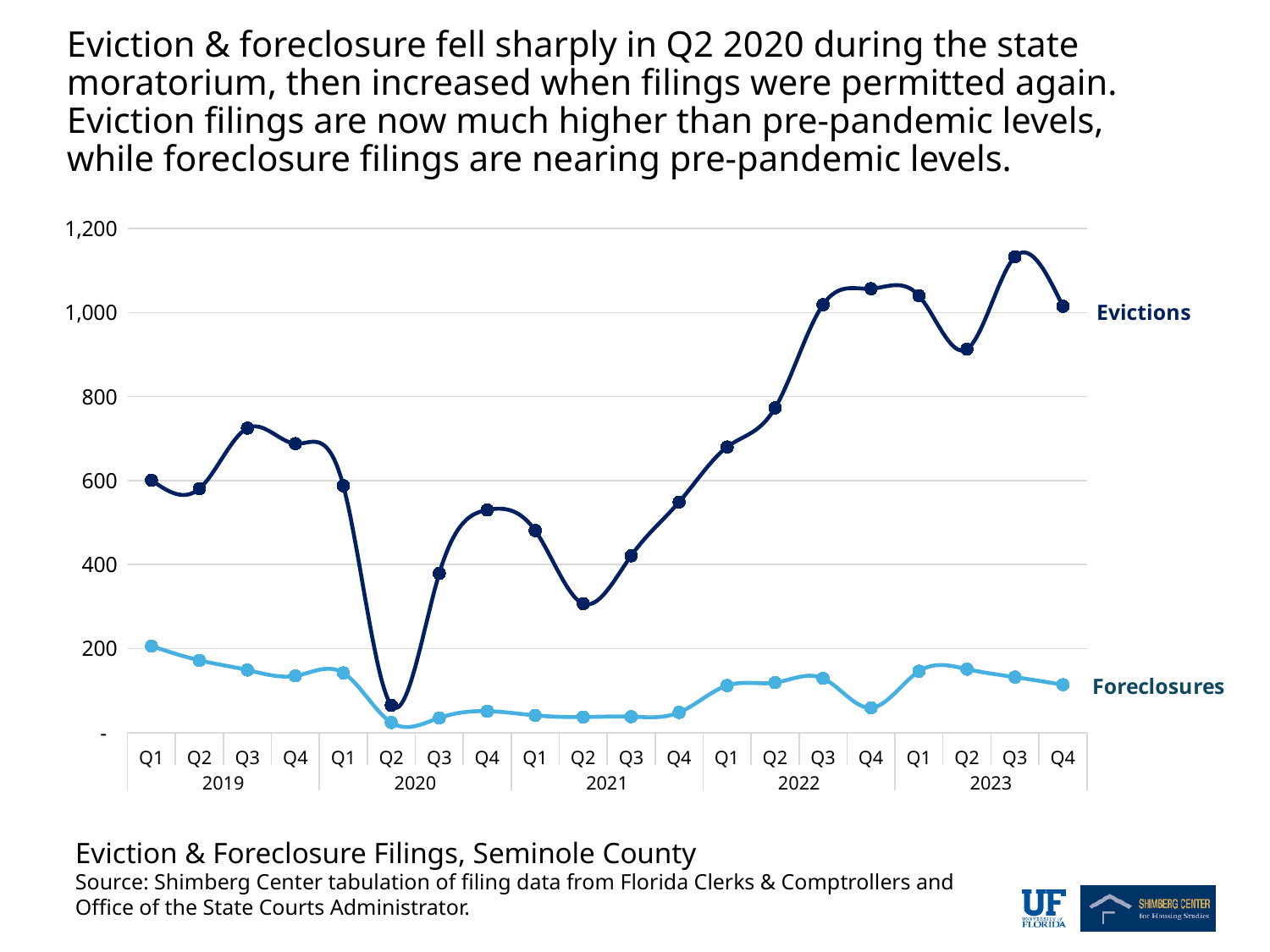
Is the value for Foreclosures in Q1 2023 greater or less than 200? less In which quarter do Evictions reach their lowest value? Q2 2020 In which quarter do Foreclosures reach their lowest value? Q2 2020 Which is larger: Evictions in Q3 2019 or Evictions in Q1 2019? Q3 2019 Do Evictions rise or fall from Q2 2020 to Q4 2020? Rise How many series does the chart show? 2 What kind of chart is shown on the slide? Line chart How many quarterly data points does each line have? 20 Is the value for Evictions in Q2 2020 greater or less than 200? less Is the value for Evictions in Q3 2023 greater or less than 1,000? greater In which quarter do Evictions reach their highest value? Q3 2023 In which quarter do Foreclosures reach their highest value? Q1 2019